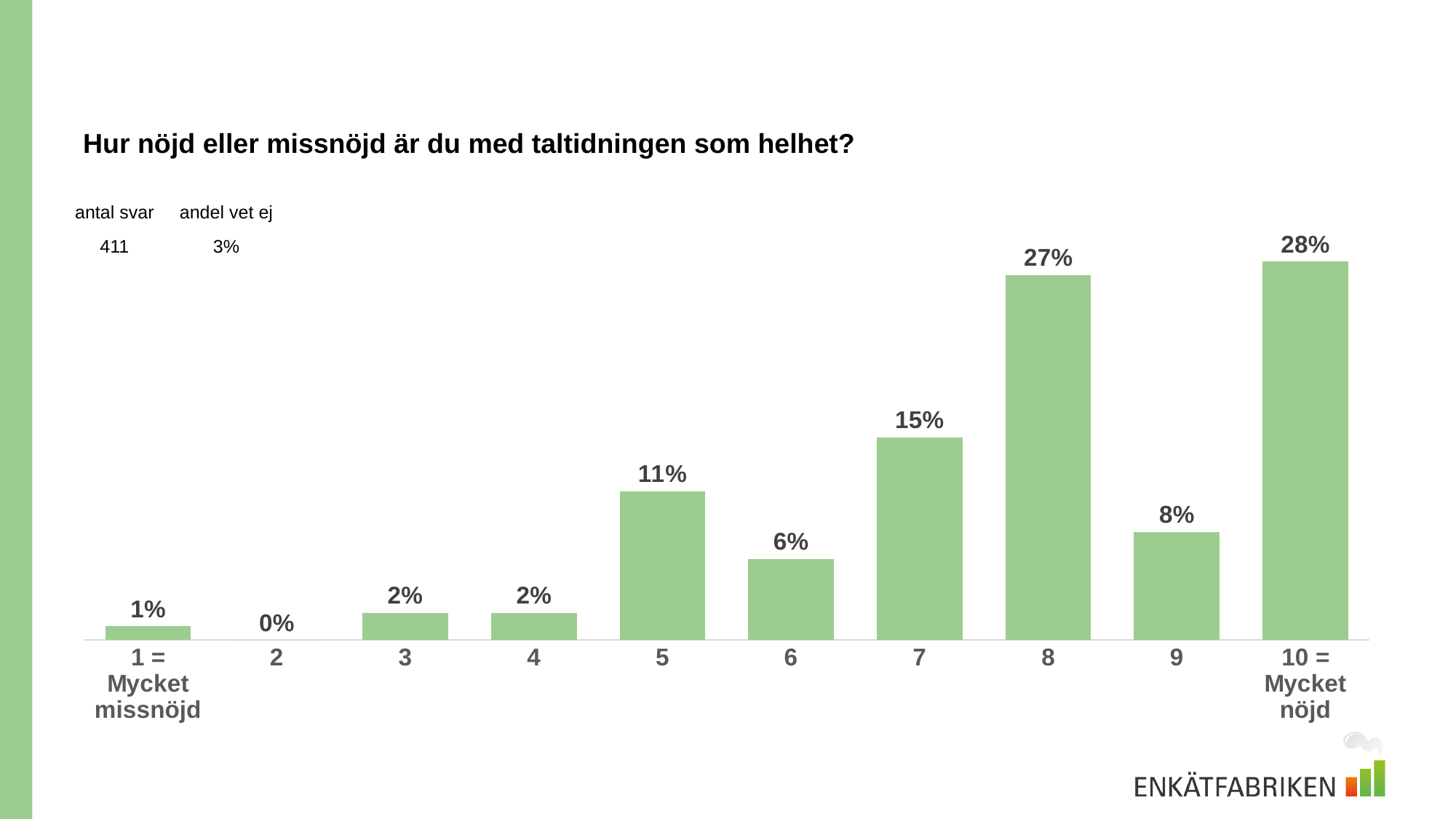
What is the difference between the values for category 10 = Mycket nöjd and category 9? 20% What is the value for category 8? 27% What is the difference between the values for category 8 and category 7? 12% Which category has the highest value? 10 = Mycket nöjd How many categories are shown on the x axis? 10 What is the value for category 5? 11% Which category has the lowest value? 2 What is the value for category 9? 8% What kind of chart is shown on the slide? bar chart What is the title of the chart? Hur nöjd eller missnöjd är du med taltidningen som helhet? What is the number of responses (antal svar) shown on the slide? 411 Which is larger, the value for category 6 or the value for category 9? 9